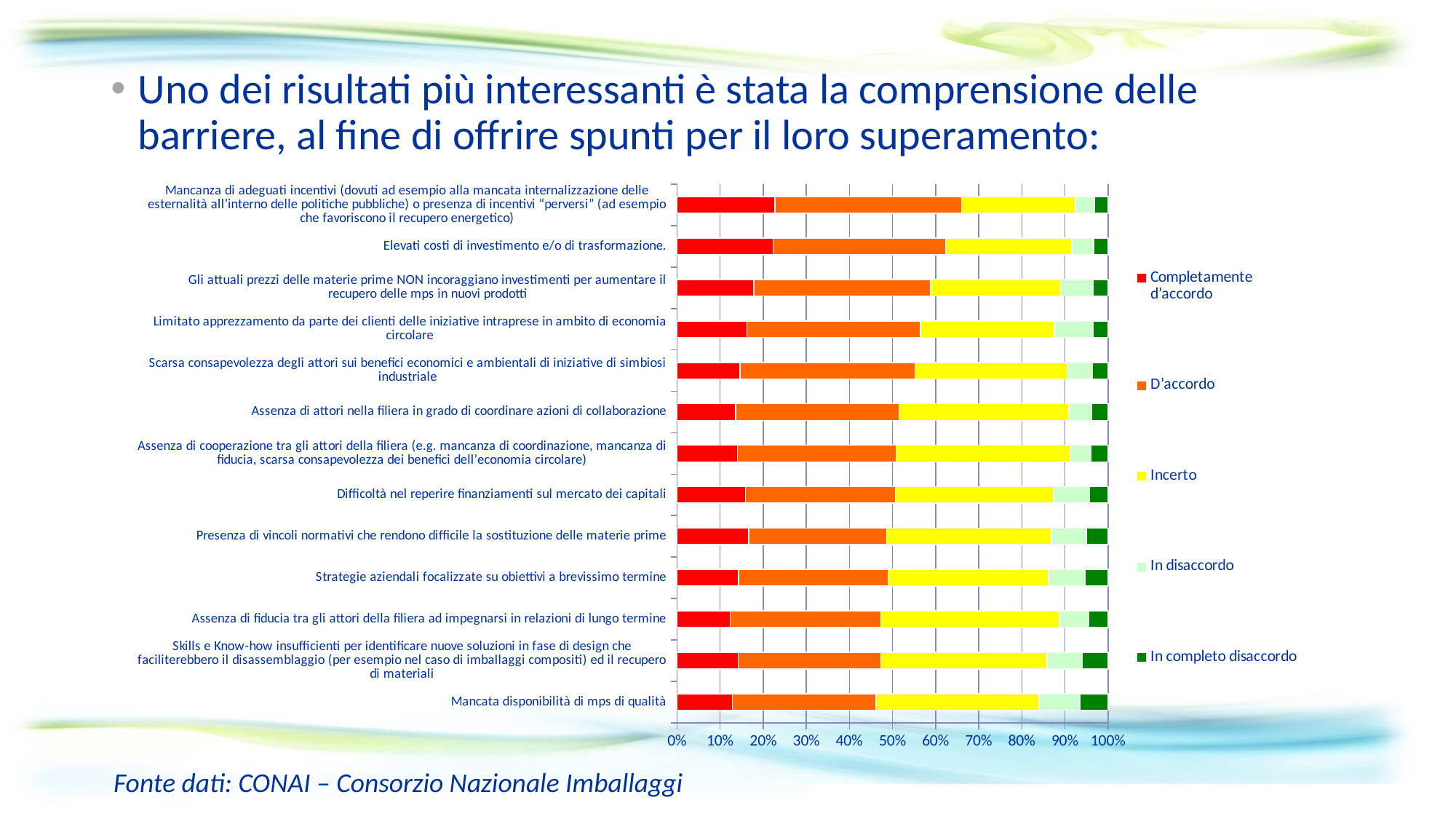
Which has the larger 'Incerto' share: 'Mancata disponibilità di mps di qualità' or 'Mancanza di adeguati incentivi'? Mancata disponibilità di mps di qualità Which has the larger 'Completamente d'accordo' share: 'Mancanza di adeguati incentivi' or 'Mancata disponibilità di mps di qualità'? Mancanza di adeguati incentivi How many series does the chart legend list? 5 What is the highest value shown on the horizontal axis of the chart? 100% Which legend entry is shown in yellow? Incerto Is the combined 'Completamente d'accordo' and 'D'accordo' share for 'Mancata disponibilità di mps di qualità' greater or less than 50%? less Is the 'Completamente d'accordo' share for 'Mancata disponibilità di mps di qualità' greater or less than 20%? less What kind of chart is shown on the slide? Stacked bar chart How many barrier categories are plotted in the chart? 13 What is the first entry in the chart legend? Completamente d'accordo Is the 'Completamente d'accordo' share for 'Mancanza di adeguati incentivi' greater or less than 20%? greater